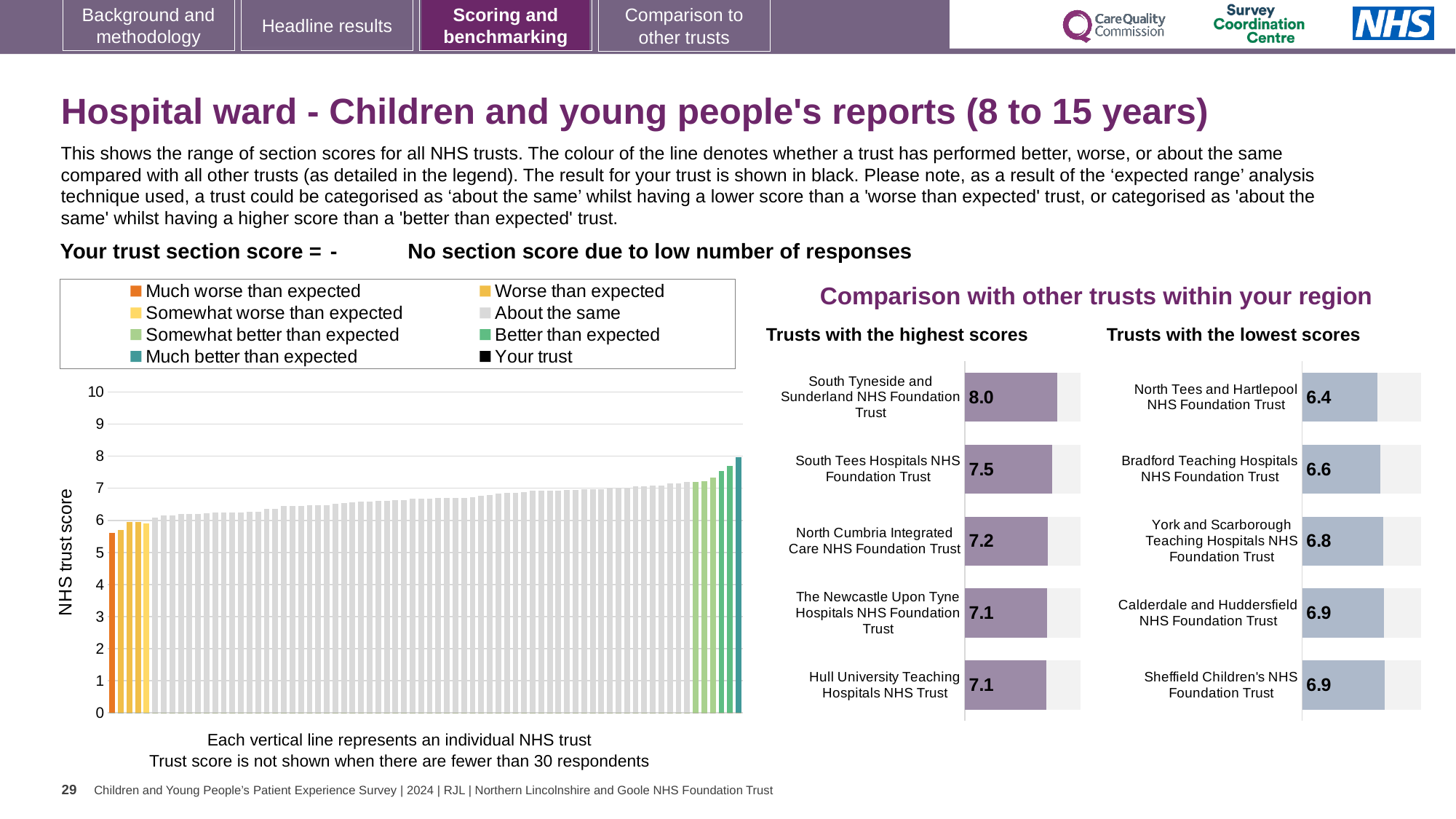
In the 'Trusts with the lowest scores' chart, what is the difference between the scores of York and Scarborough Teaching Hospitals NHS Foundation Trust and North Tees and Hartlepool NHS Foundation Trust? 0.4 In the 'Trusts with the lowest scores' chart, what is the score for Bradford Teaching Hospitals NHS Foundation Trust? 6.6 In the 'Trusts with the highest scores' chart, what is the score for South Tyneside and Sunderland NHS Foundation Trust? 8.0 How many entries does the legend of the 'NHS trust score' chart list? 8 In the 'NHS trust score' chart, do the bar values rise or fall from left to right? Rise In the 'Trusts with the highest scores' chart, what is the score for North Cumbria Integrated Care NHS Foundation Trust? 7.2 Which has a higher score: Hull University Teaching Hospitals NHS Trust in the 'highest scores' chart or Sheffield Children's NHS Foundation Trust in the 'lowest scores' chart? Hull University Teaching Hospitals NHS Trust In the 'Trusts with the highest scores' chart, what is the difference between the scores of South Tyneside and Sunderland NHS Foundation Trust and South Tees Hospitals NHS Foundation Trust? 0.5 How many trusts are shown in the 'Trusts with the lowest scores' chart? 5 What type of chart is the 'NHS trust score' chart on the left of the slide? Bar chart In the 'Trusts with the lowest scores' chart, which trust has the lowest score? North Tees and Hartlepool NHS Foundation Trust In the 'Trusts with the highest scores' chart, which trust has the highest score? South Tyneside and Sunderland NHS Foundation Trust